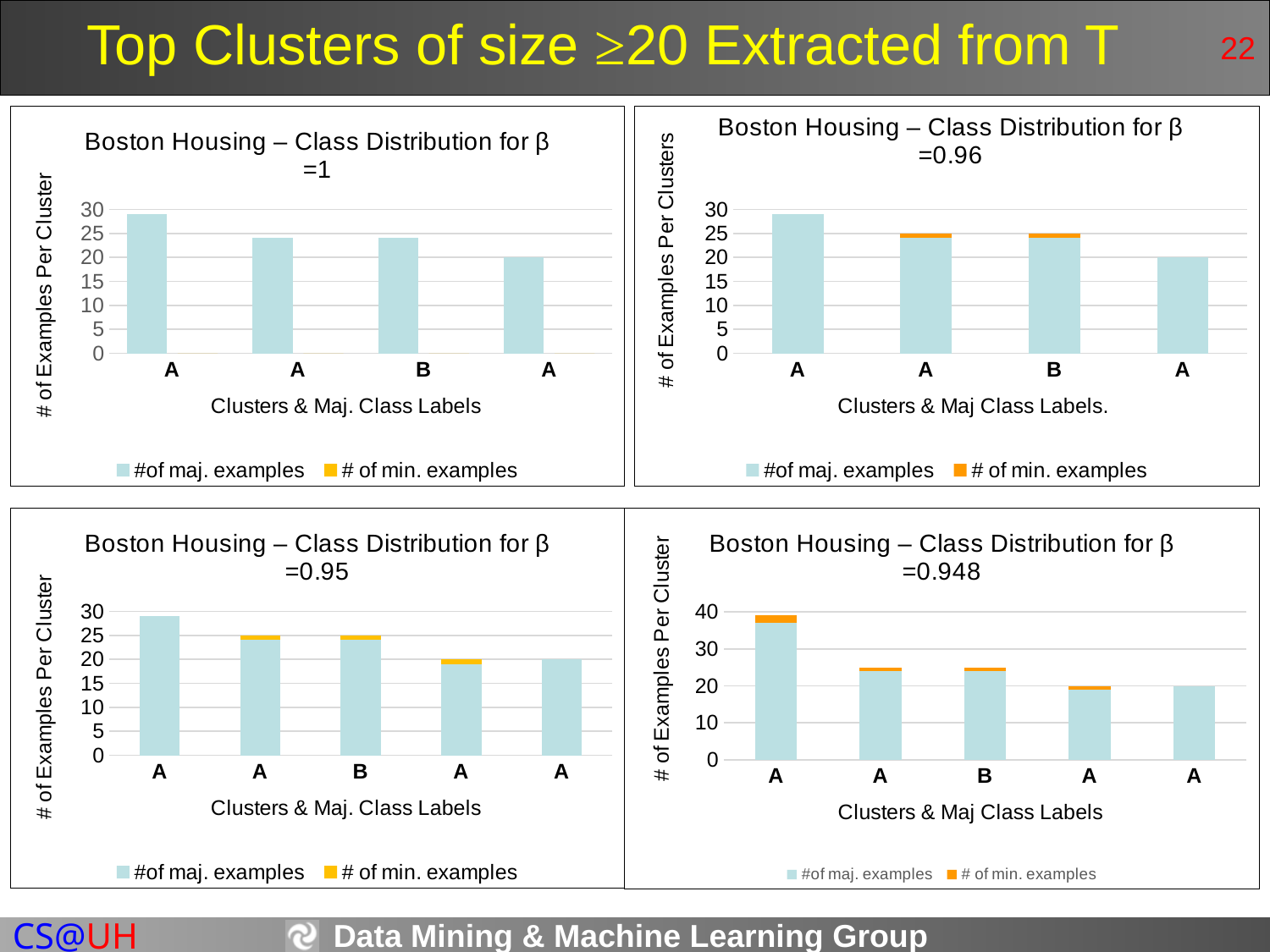
How many series does the legend of the 'Boston Housing – Class Distribution for β =0.96' chart list? 2 In the 'Boston Housing – Class Distribution for β =1' chart, which bar is the tallest? the first bar (A) In the 'Boston Housing – Class Distribution for β =0.948' chart, do the bar heights rise or fall from left to right? fall How many bars are shown in the 'Boston Housing – Class Distribution for β =1' chart? 4 In the 'Boston Housing – Class Distribution for β =1' chart, is the value of the bar labelled B greater or less than 20? greater In the 'Boston Housing – Class Distribution for β =1' chart, which bar is the shortest? the last bar (A) In the 'Boston Housing – Class Distribution for β =0.948' chart, which is larger, the first bar (A) or the last bar (A)? the first bar (A) What kind of chart is the 'Boston Housing – Class Distribution for β =1' chart? bar chart In the 'Boston Housing – Class Distribution for β =1' chart, is the value of the first bar (A) greater or less than 25? greater In the 'Boston Housing – Class Distribution for β =0.948' chart, is the total of the first bar (A) greater or less than 30? greater What are the two legend entries in the 'Boston Housing – Class Distribution for β =0.95' chart? #of maj. examples and # of min. examples How many bars are shown in the 'Boston Housing – Class Distribution for β =0.95' chart? 5